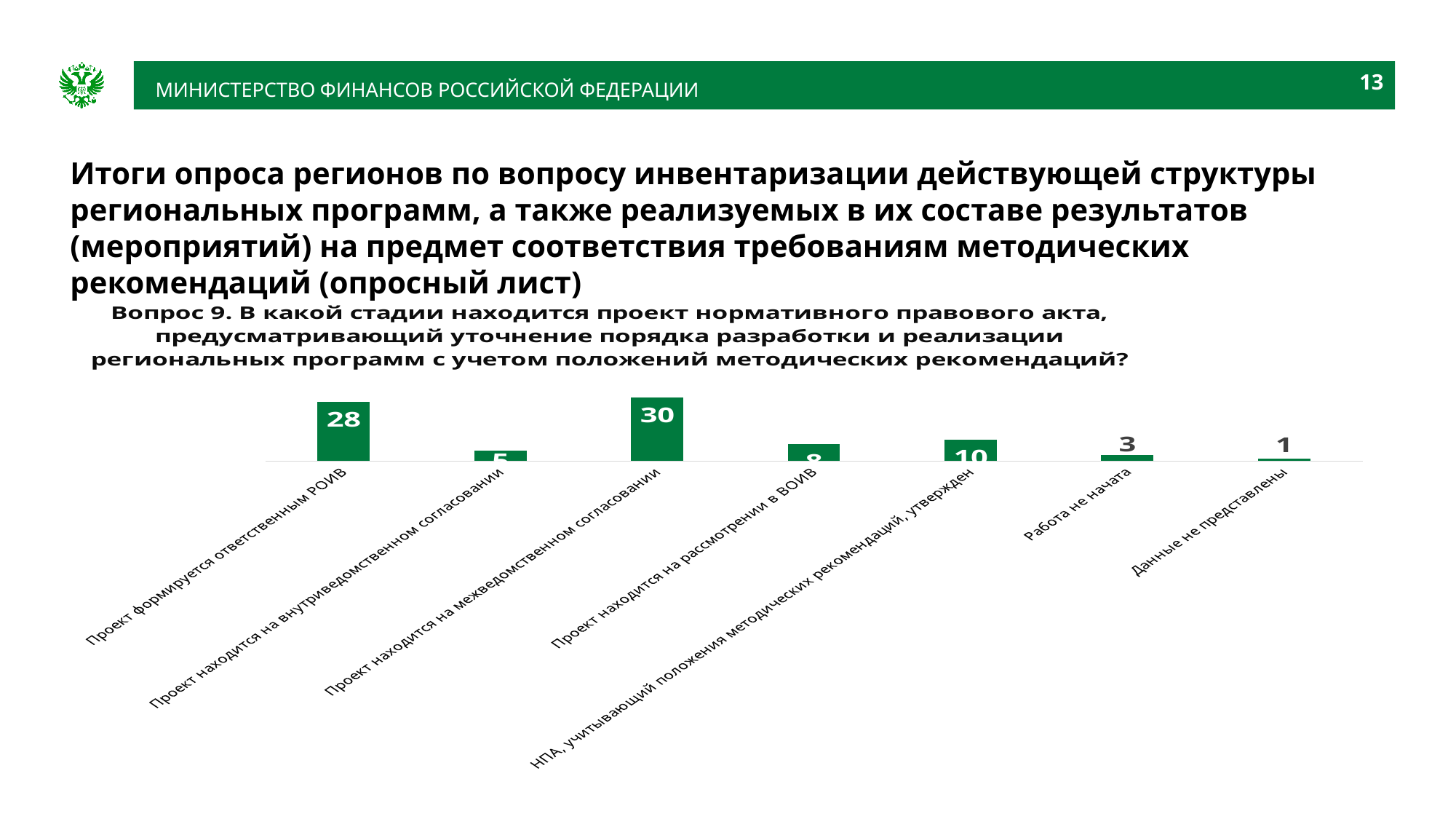
What is the value for "Проект находится на межведомственном согласовании"? 30 What is the value for "Данные не представлены"? 1 What type of chart is shown on the slide? bar chart What is the value for "Работа не начата"? 3 What is the difference between the values for "Проект находится на межведомственном согласовании" and "Проект формируется ответственным РОИВ"? 2 Which category has the lowest value? Данные не представлены What is the value for "Проект формируется ответственным РОИВ"? 28 How many categories are shown in the chart? 7 What is the value for "НПА, учитывающий положения методических рекомендаций, утвержден"? 10 Which is larger: the value for "НПА, учитывающий положения методических рекомендаций, утвержден" or the value for "Работа не начата"? НПА, учитывающий положения методических рекомендаций, утвержден What question number is the chart title about? Вопрос 9 Which category has the highest value? Проект находится на межведомственном согласовании